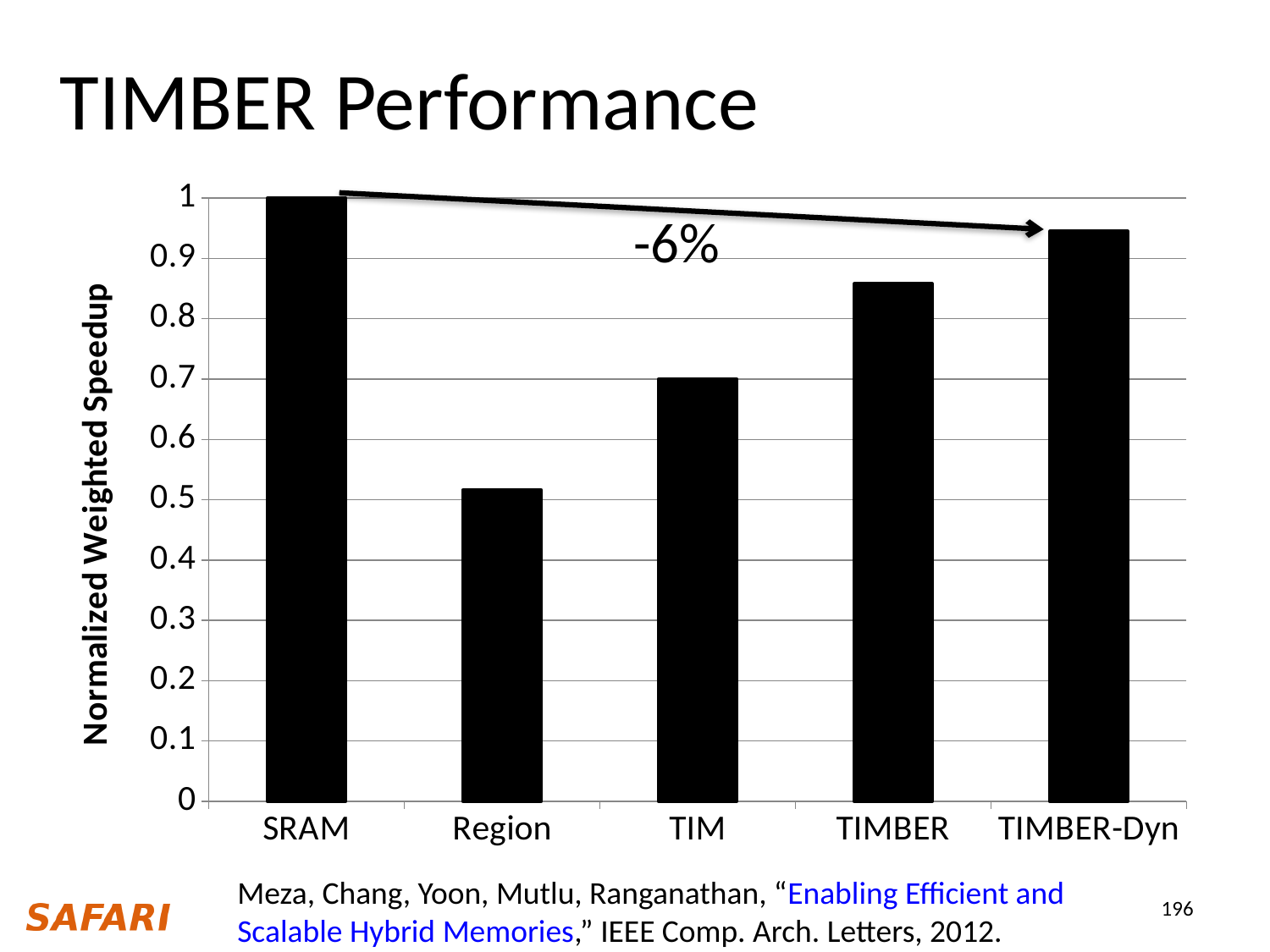
Which category has the lowest Normalized Weighted Speedup? Region How many categories are plotted on the x axis of the chart? 5 Is the value for TIMBER-Dyn greater or less than 0.9? greater What percentage change is annotated by the arrow from SRAM to TIMBER-Dyn? -6% Which has a larger Normalized Weighted Speedup, TIMBER or TIM? TIMBER Is the value for Region greater or less than 0.6? less Which category has the highest Normalized Weighted Speedup? SRAM Is the value for TIMBER greater or less than 0.8? greater What kind of chart is shown on the slide? bar chart What is the label of the y axis? Normalized Weighted Speedup What is the Normalized Weighted Speedup for SRAM? 1